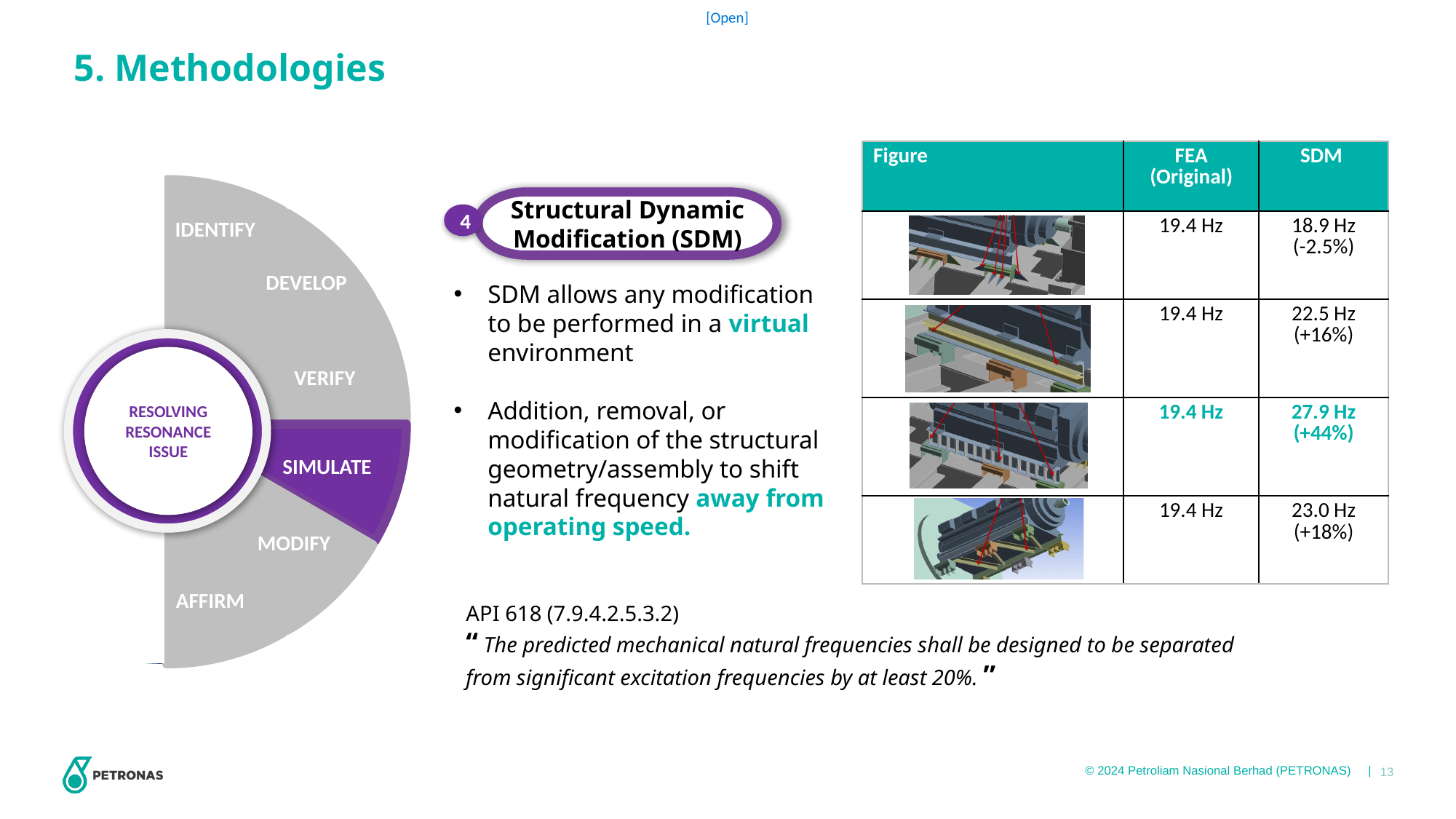
In the semicircular process diagram on the left, how many stage segments are shown? 6 In the table on the right, is the SDM frequency for the second row larger or smaller than its FEA (Original) frequency? larger In the semicircular process diagram on the left, what text appears in the central circle? RESOLVING RESONANCE ISSUE In the semicircular process diagram on the left, which stage segment is highlighted in purple? SIMULATE In the table on the right, how many figure rows are listed? 4 In the table on the right, which figure row has the highest SDM frequency? The third row (27.9 Hz) In the table on the right, what is the SDM frequency for the fourth figure row? 23.0 Hz (+18%) In the table on the right, what is the difference between the SDM frequency and the FEA (Original) frequency in the third row? 8.5 Hz In the table on the right, what is the FEA (Original) frequency for the first figure row? 19.4 Hz In the table on the right, what is the SDM frequency for the third figure row? 27.9 Hz (+44%) In the table on the right, which figure row has the lowest SDM frequency? The first row (18.9 Hz)